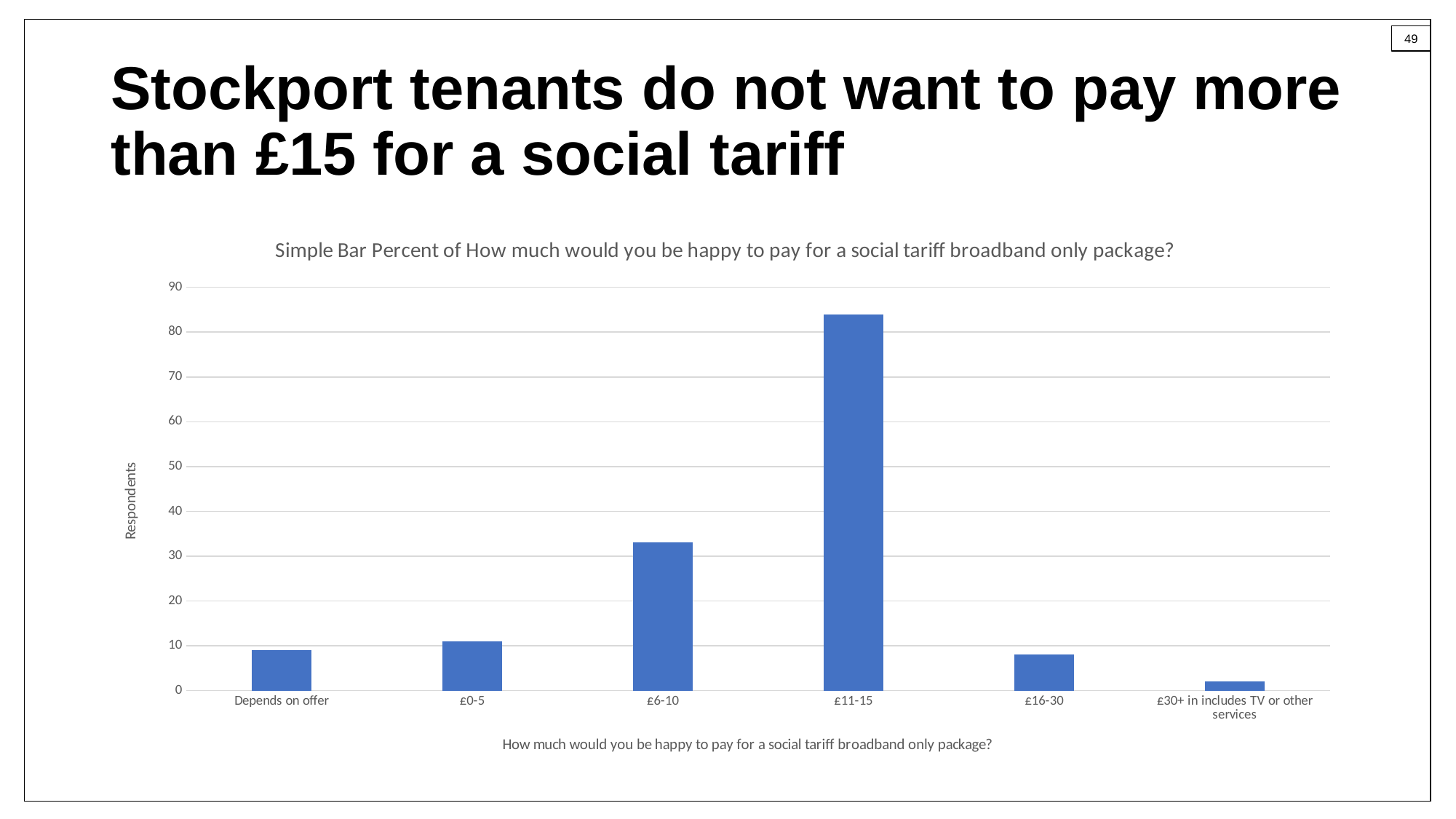
Is the value for £6-10 greater or less than 30? greater Is the value for £16-30 greater or less than 10? less Is the value for Depends on offer greater or less than 20? less Which category has the lowest number of respondents? £30+ in includes TV or other services What kind of chart is shown on the slide? bar chart Which category has the highest number of respondents? £11-15 What is the label of the y axis of the chart? Respondents Which has more respondents, £16-30 or £30+ in includes TV or other services? £16-30 Which has more respondents, £6-10 or £0-5? £6-10 How many categories are shown on the x axis of the chart? 6